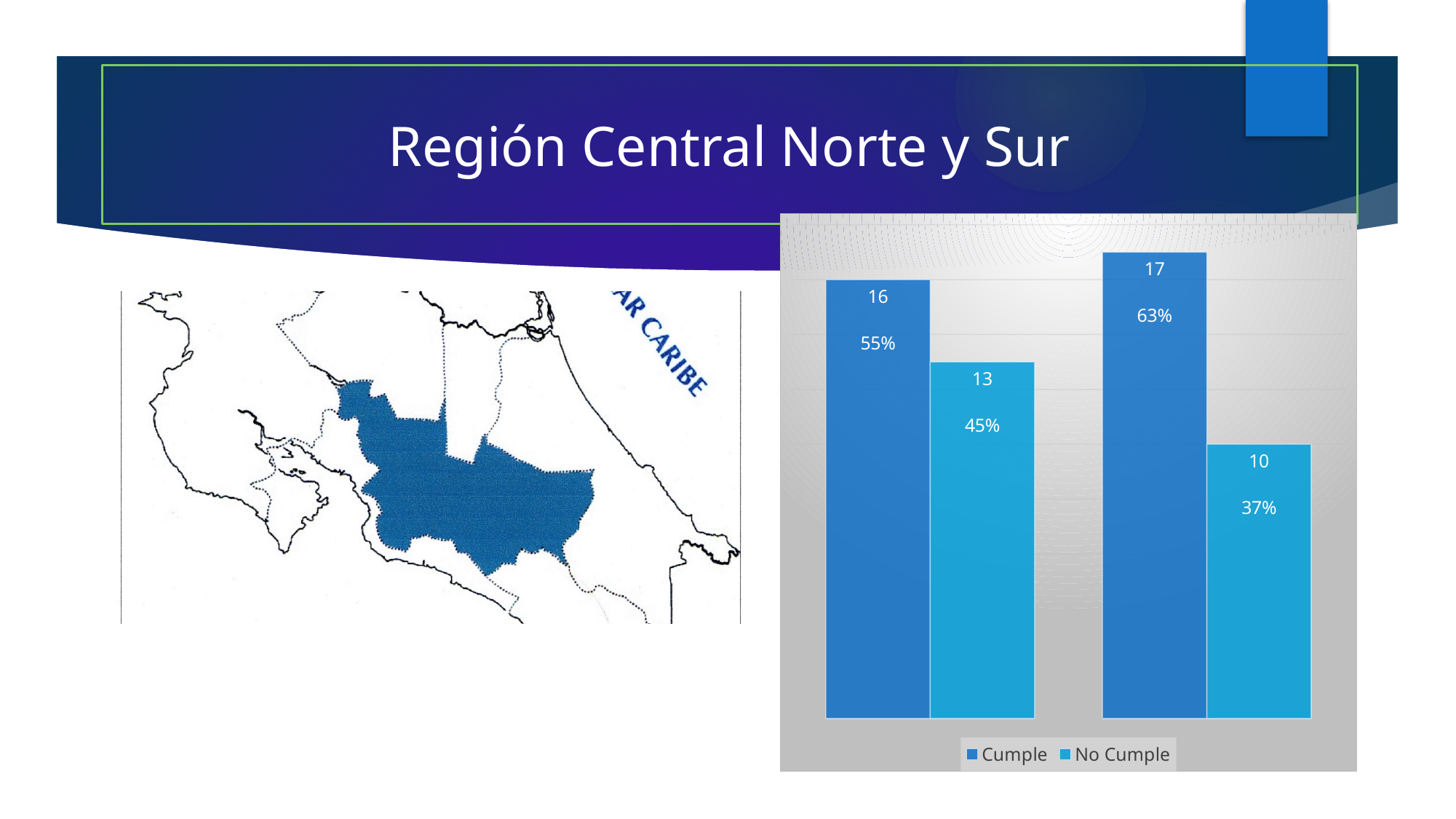
What percentage is shown on the No Cumple bar in the right group of the chart? 37% Which bar in the chart has the lowest value? No Cumple in the right group (10) What is the count value of the Cumple bar in the left group of the chart? 16 What type of chart is shown on the slide? bar chart Which bar in the chart has the highest value? Cumple in the right group (17) How many groups of bars are plotted in the chart? 2 How many series does the chart legend list? 2 What are the two series named in the chart legend? Cumple and No Cumple What is the difference between the Cumple and No Cumple counts in the right group of the chart? 7 What percentage is shown on the No Cumple bar in the left group of the chart? 45% In the left group of the chart, which is larger, Cumple or No Cumple? Cumple What is the count value of the Cumple bar in the right group of the chart? 17